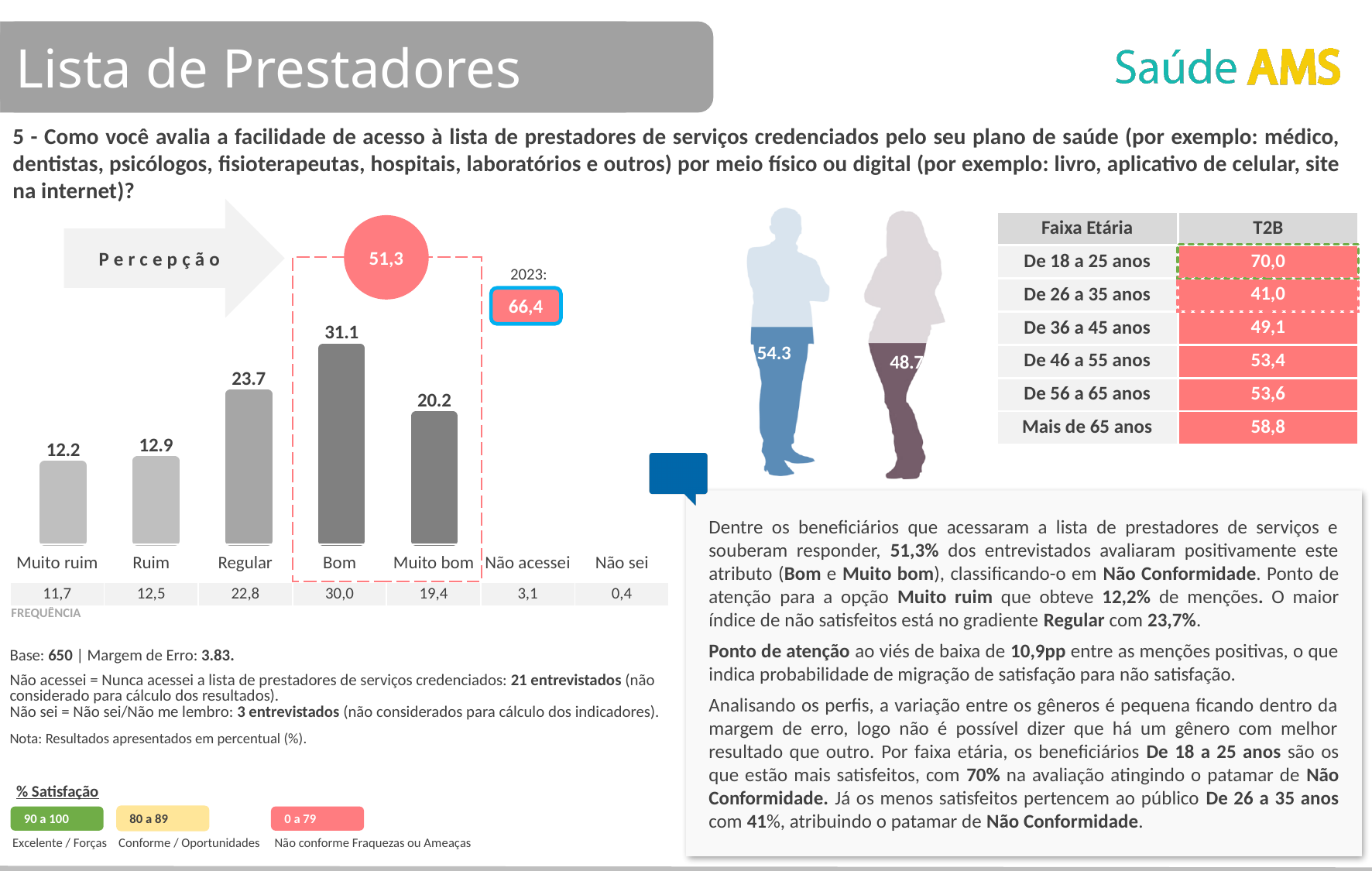
What is the difference between the Regular bar and the Ruim bar? 10.8 What is the difference between the Bom bar and the Muito bom bar? 10.9 What is the value of the Bom bar in the bar chart? 31.1 What is the value of the Muito ruim bar in the bar chart? 12.2 What is the value of the Regular bar in the bar chart? 23.7 How many bars are plotted in the bar chart? 5 Which is larger in the bar chart, Regular or Muito bom? Regular What value is shown in the pink circle above the dashed box grouping Bom and Muito bom? 51,3 Which category has the highest bar in the bar chart? Bom What kind of chart is shown on the left of the slide? Bar chart What is the value of the Muito bom bar in the bar chart? 20.2 Which category has the lowest bar in the bar chart? Muito ruim